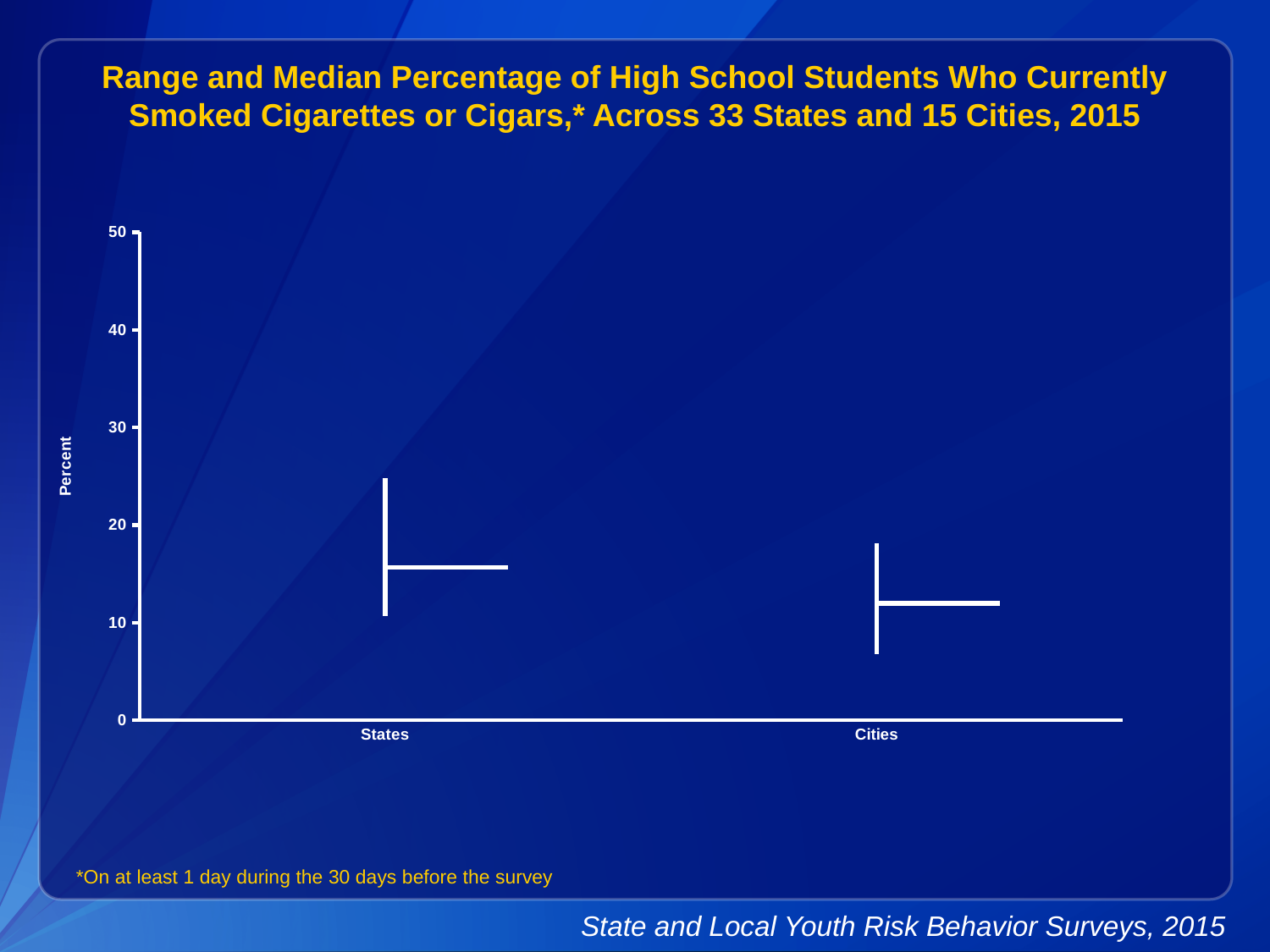
Is the bottom of the range for Cities greater or less than 10? less Is the median value for States greater or less than 10? greater Is the median value for Cities greater or less than 10? greater What is the label of the y axis? Percent Which group has the higher median percentage, States or Cities? States How many categories are shown on the x axis? 2 What is the maximum value shown on the y axis? 50 Which group has the lower median percentage? Cities